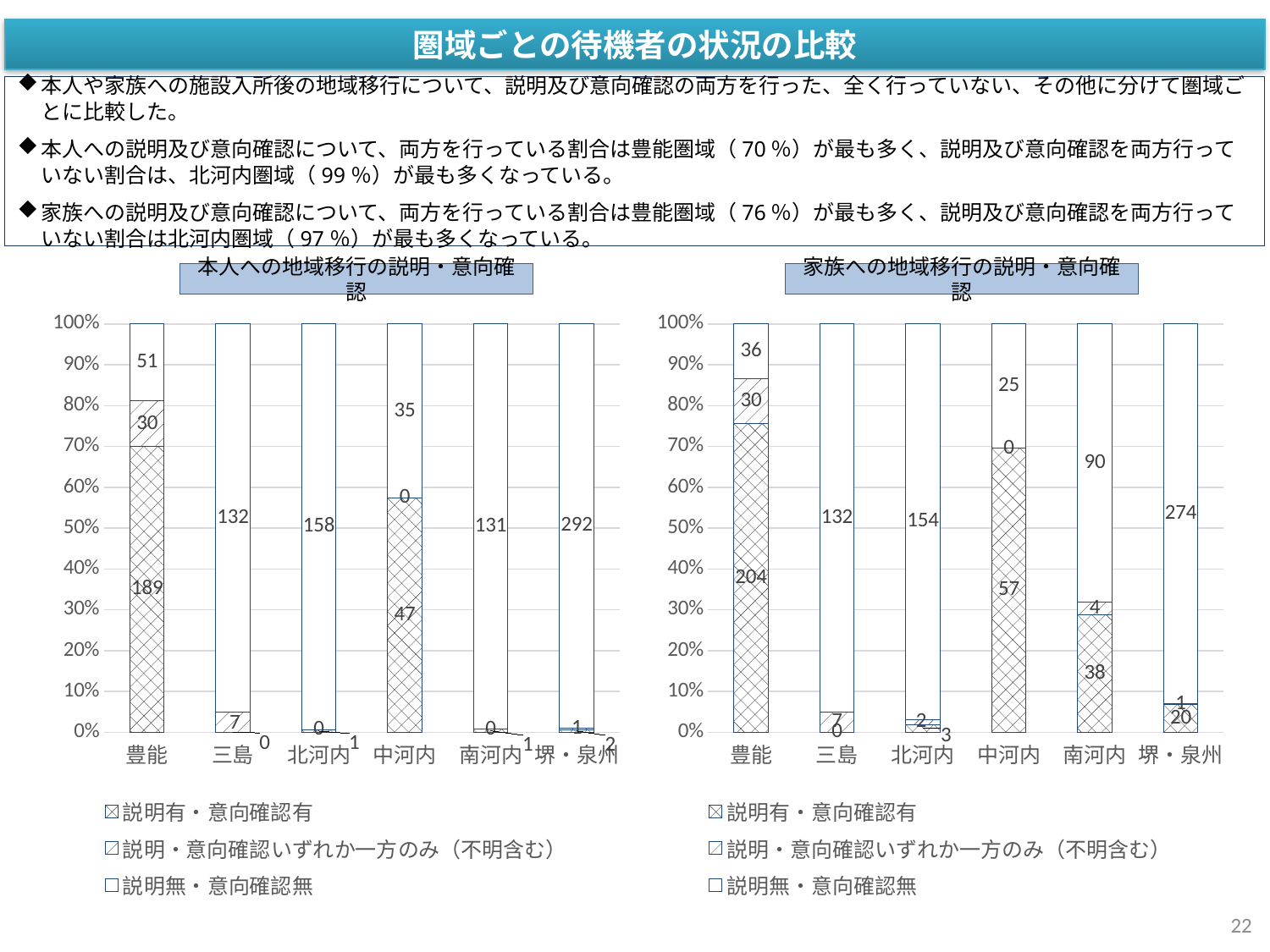
How many categories are shown on the x axis of the right chart (家族への地域移行の説明・意向確認)? 6 In the right chart (家族への地域移行の説明・意向確認), what is the difference between the 説明無・意向確認無 values for 堺・泉州 and 三島? 142 In the right chart (家族への地域移行の説明・意向確認), what is the value of 説明無・意向確認無 for 南河内? 90 In the left chart (本人への地域移行の説明・意向確認), which category has the highest value for 説明無・意向確認無? 堺・泉州 In the left chart (本人への地域移行の説明・意向確認), what is the value of 説明有・意向確認有 for 豊能? 189 In the left chart (本人への地域移行の説明・意向確認), what is the value of 説明無・意向確認無 for 堺・泉州? 292 How many series does the legend of the left chart (本人への地域移行の説明・意向確認) list? 3 In the right chart (家族への地域移行の説明・意向確認), what is the value of 説明有・意向確認有 for 豊能? 204 In the left chart (本人への地域移行の説明・意向確認), what is the total of the three segments for 豊能? 270 In the right chart (家族への地域移行の説明・意向確認), which category has the lowest value for 説明無・意向確認無? 中河内 In the left chart (本人への地域移行の説明・意向確認), which is larger: the 説明有・意向確認有 value for 豊能 or for 中河内? 豊能 What kind of chart is the right chart (家族への地域移行の説明・意向確認)? 100% stacked bar chart